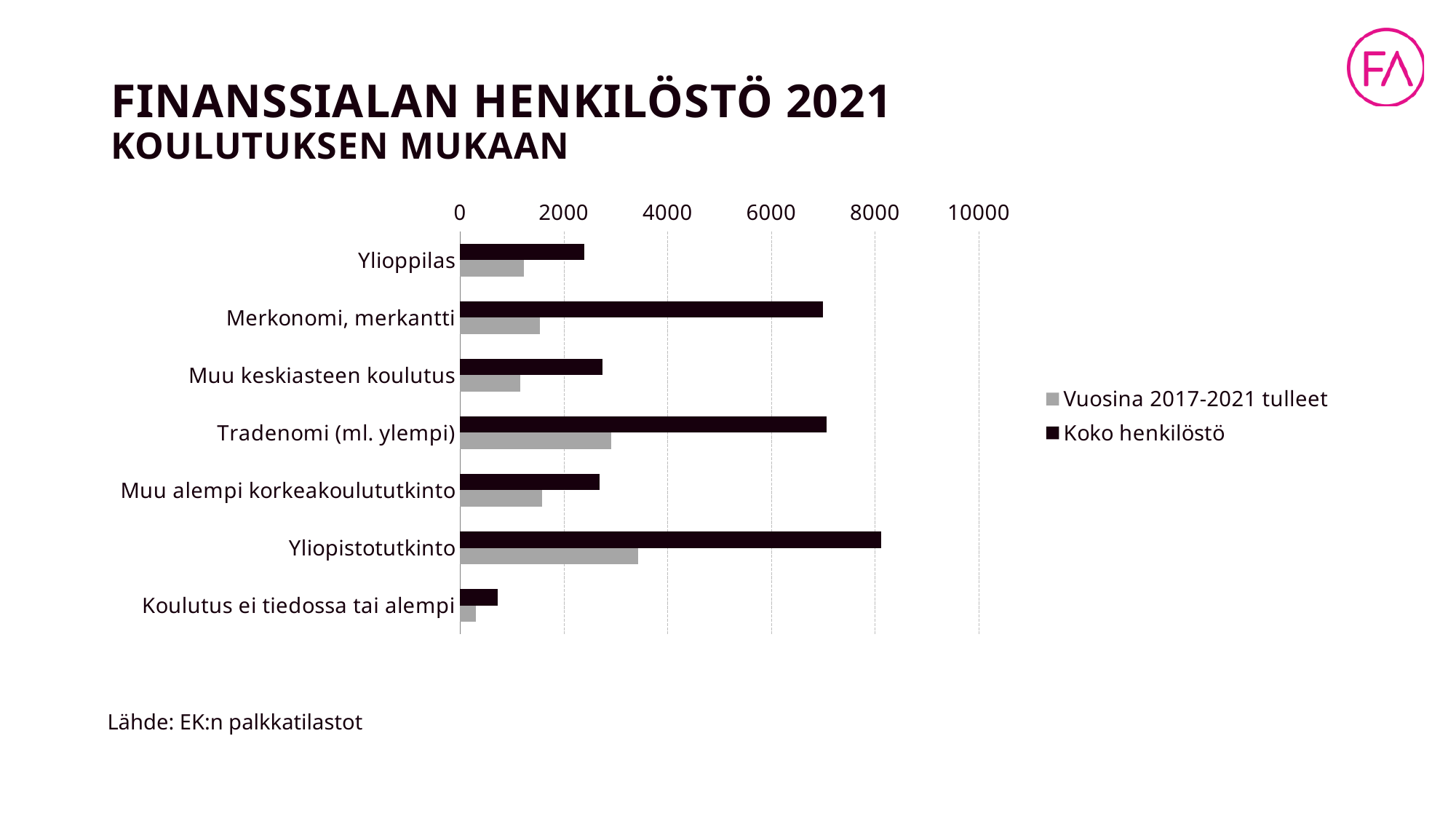
Which category has the lowest value for Koko henkilöstö? Koulutus ei tiedossa tai alempi Which category has the lowest value for Vuosina 2017-2021 tulleet? Koulutus ei tiedossa tai alempi Which category has the highest value for Vuosina 2017-2021 tulleet? Yliopistotutkinto Is the Koko henkilöstö value for Ylioppilas greater or less than 4000? less Is the Vuosina 2017-2021 tulleet value for Tradenomi (ml. ylempi) greater or less than 2000? greater How many education categories are shown on the chart? 7 For Vuosina 2017-2021 tulleet, which is larger: Tradenomi (ml. ylempi) or Merkonomi, merkantti? Tradenomi (ml. ylempi) Is the Koko henkilöstö value for Merkonomi, merkantti greater or less than 6000? greater What is the title of the chart on the slide? FINANSSIALAN HENKILÖSTÖ 2021 KOULUTUKSEN MUKAAN Which category has the highest value for Koko henkilöstö? Yliopistotutkinto What kind of chart is shown on the slide? bar chart How many series does the legend list? 2